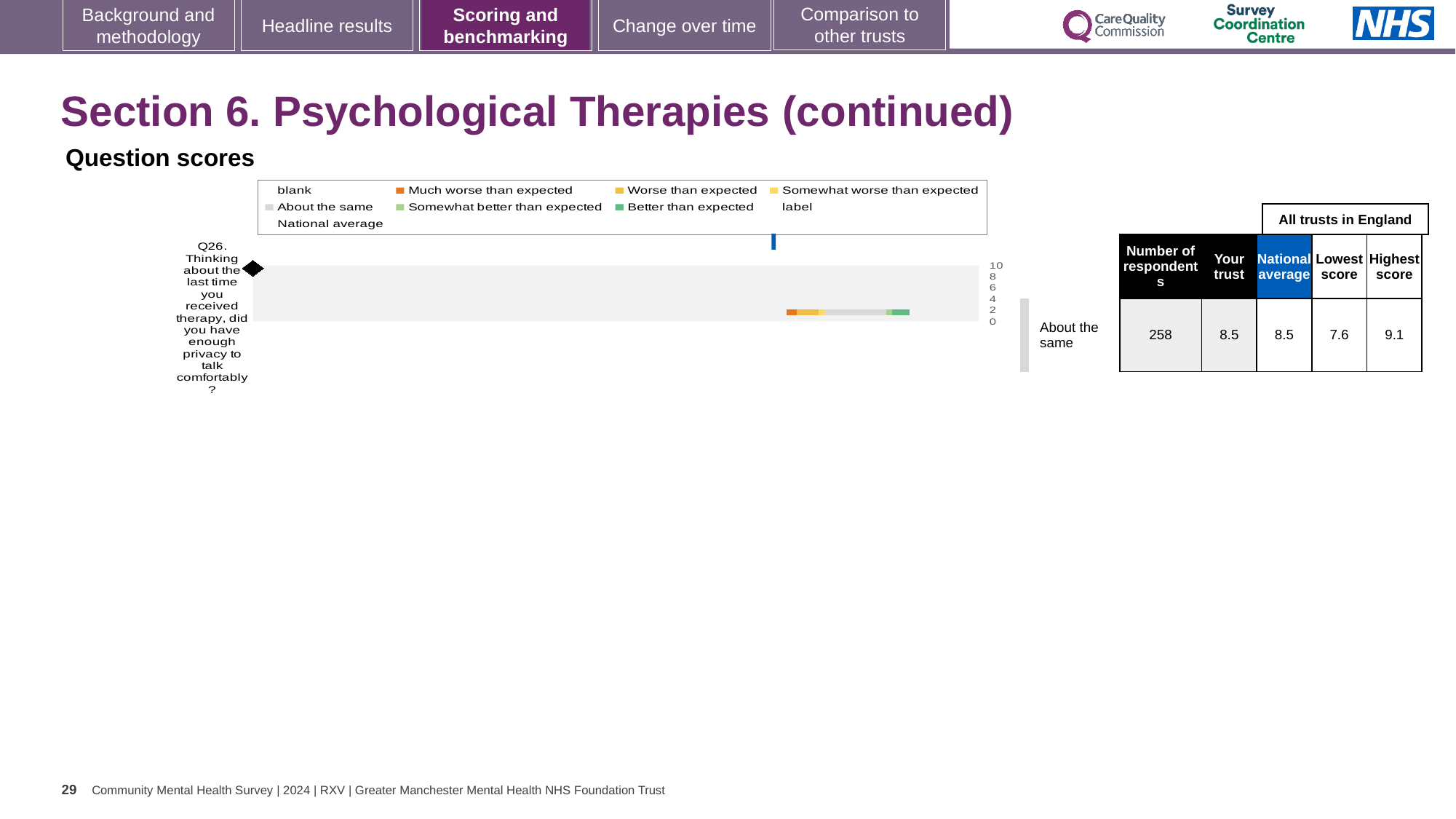
What benchmarking category label is shown next to the Q26 bar? About the same Is the trust's Q26 score greater or less than 6 on the chart's axis? greater What is the highest score among all trusts in England for Q26? 9.1 How many respondents answered Q26? 258 What is the difference between the highest score and the lowest score for Q26? 1.5 How many survey questions are plotted in the Question scores chart? 1 What is the lowest score among all trusts in England for Q26? 7.6 What is the 'Your trust' score for Q26 (privacy to talk comfortably during therapy)? 8.5 By how much does the trust's Q26 score exceed the lowest score in England? 0.9 What is the national average score for Q26? 8.5 What is the highest tick value shown on the chart's score axis? 10 What kind of chart is used to show the Q26 question score? bar chart